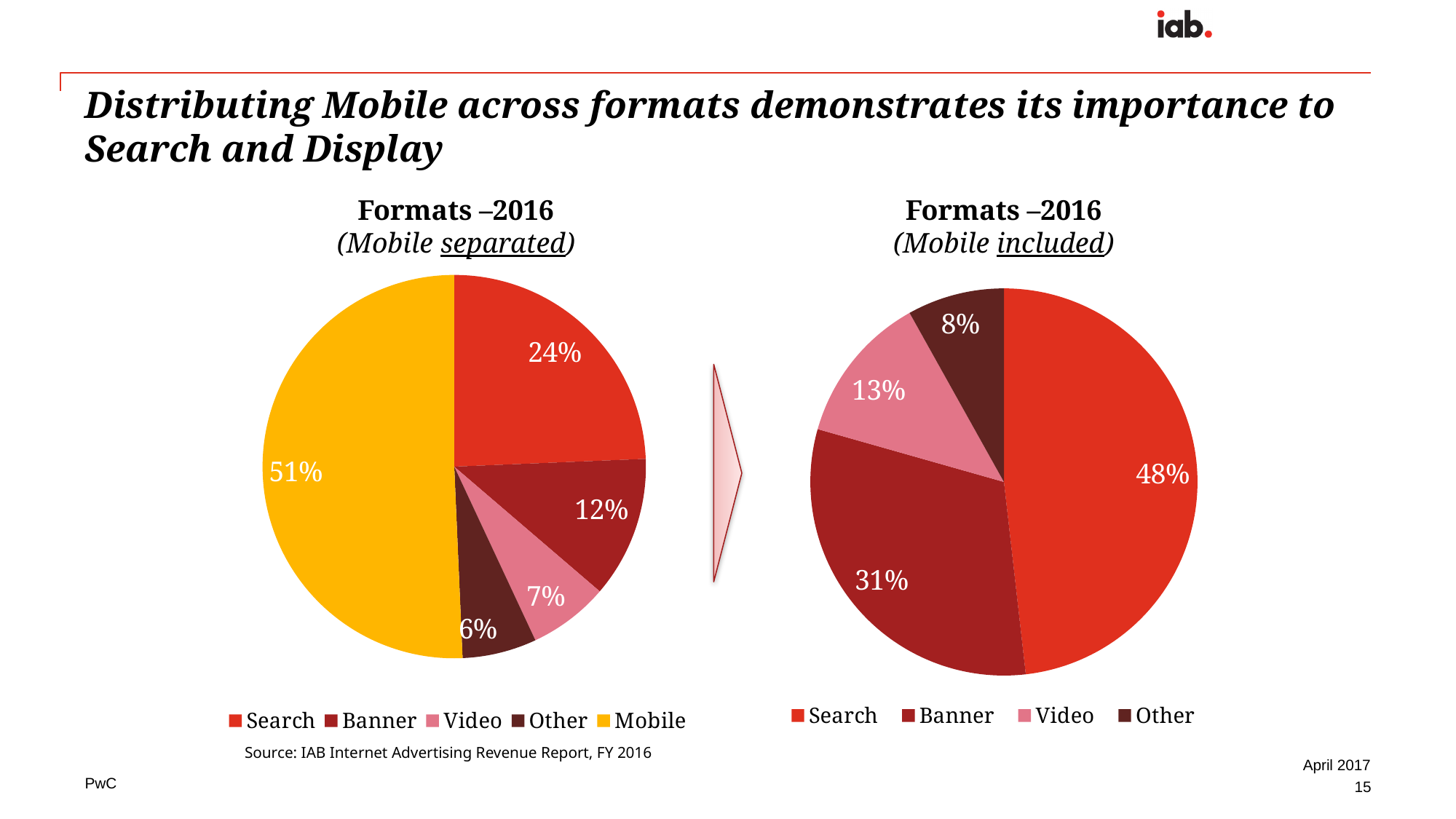
In the 'Formats – 2016 (Mobile included)' pie chart, what is the difference between the Search and Banner shares? 17% In the 'Formats – 2016 (Mobile included)' pie chart, what share does Video have? 13% In the 'Formats – 2016 (Mobile separated)' pie chart, which is larger, Banner or Video? Banner In the 'Formats – 2016 (Mobile included)' pie chart, which format has the largest share? Search In the 'Formats – 2016 (Mobile separated)' pie chart, what share does Search have? 24% What type of chart is used on the left side of the slide? Pie chart In the 'Formats – 2016 (Mobile included)' pie chart, what share does Banner have? 31% How many entries does the legend of the 'Formats – 2016 (Mobile included)' pie chart list? 4 How many slices does the 'Formats – 2016 (Mobile separated)' pie chart have? 5 In the 'Formats – 2016 (Mobile separated)' pie chart, which format has the largest share? Mobile In the 'Formats – 2016 (Mobile separated)' pie chart, which format has the smallest share? Other In the 'Formats – 2016 (Mobile separated)' pie chart, what share does Mobile have? 51%